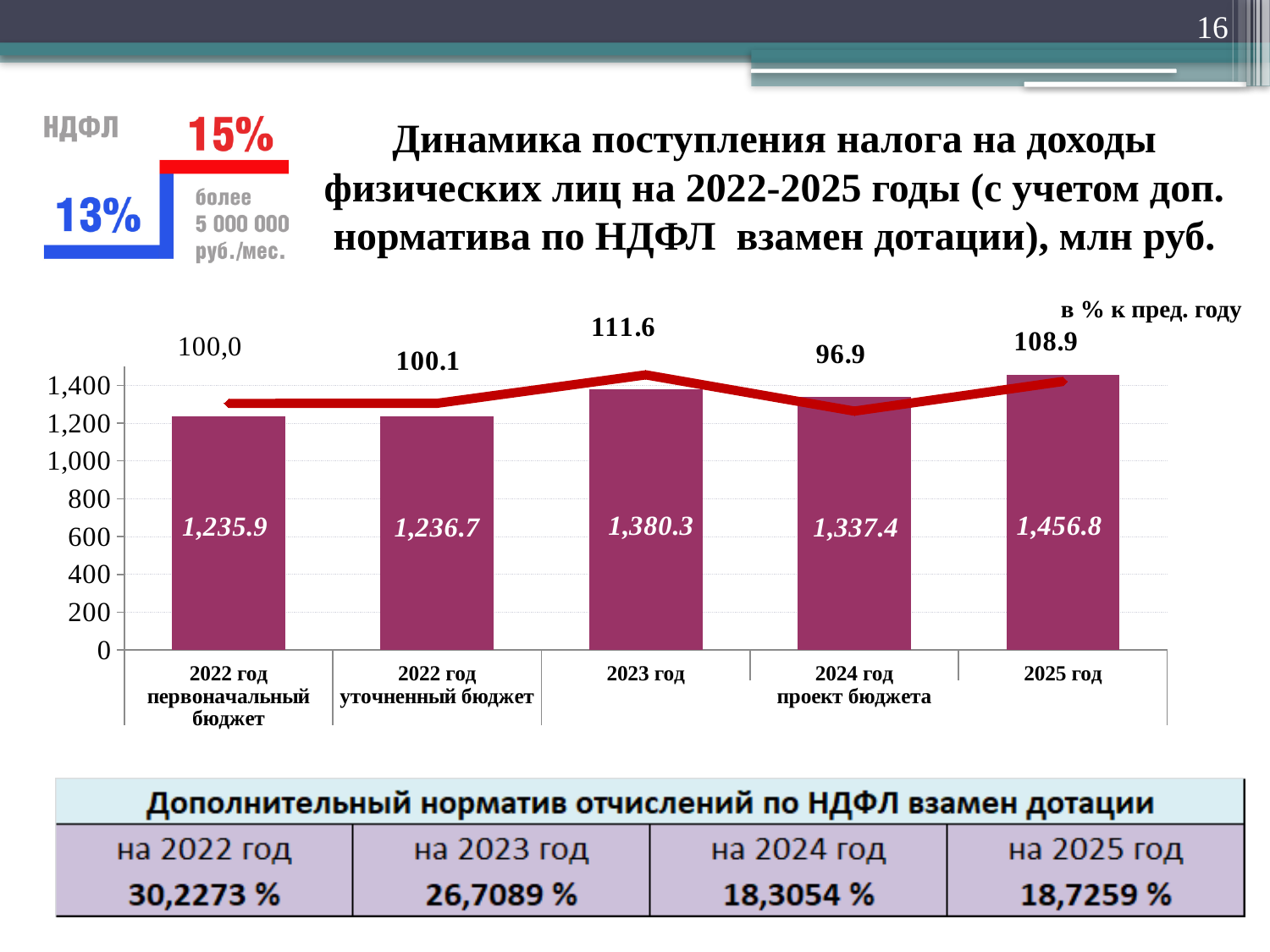
What is the percentage to the previous year (в % к пред. году) shown for 2024 год проект бюджета? 96.9 Which is larger, the value for 2023 год or the value for 2024 год проект бюджета? 2023 год What is the value for 2023 год? 1,380.3 What is the difference between the values for 2023 год and 2024 год проект бюджета? 42.9 How many bars are shown in the chart? 5 Which category has the lowest bar value? 2022 год первоначальный бюджет What kind of chart is used to show the values in млн руб.? bar chart What is the value for 2025 год? 1,456.8 Which category has the highest bar value? 2025 год What is the value for 2022 год уточненный бюджет? 1,236.7 Is the value for 2025 год greater or less than 1,400? greater What is the difference between the values for 2025 год and 2023 год? 76.5